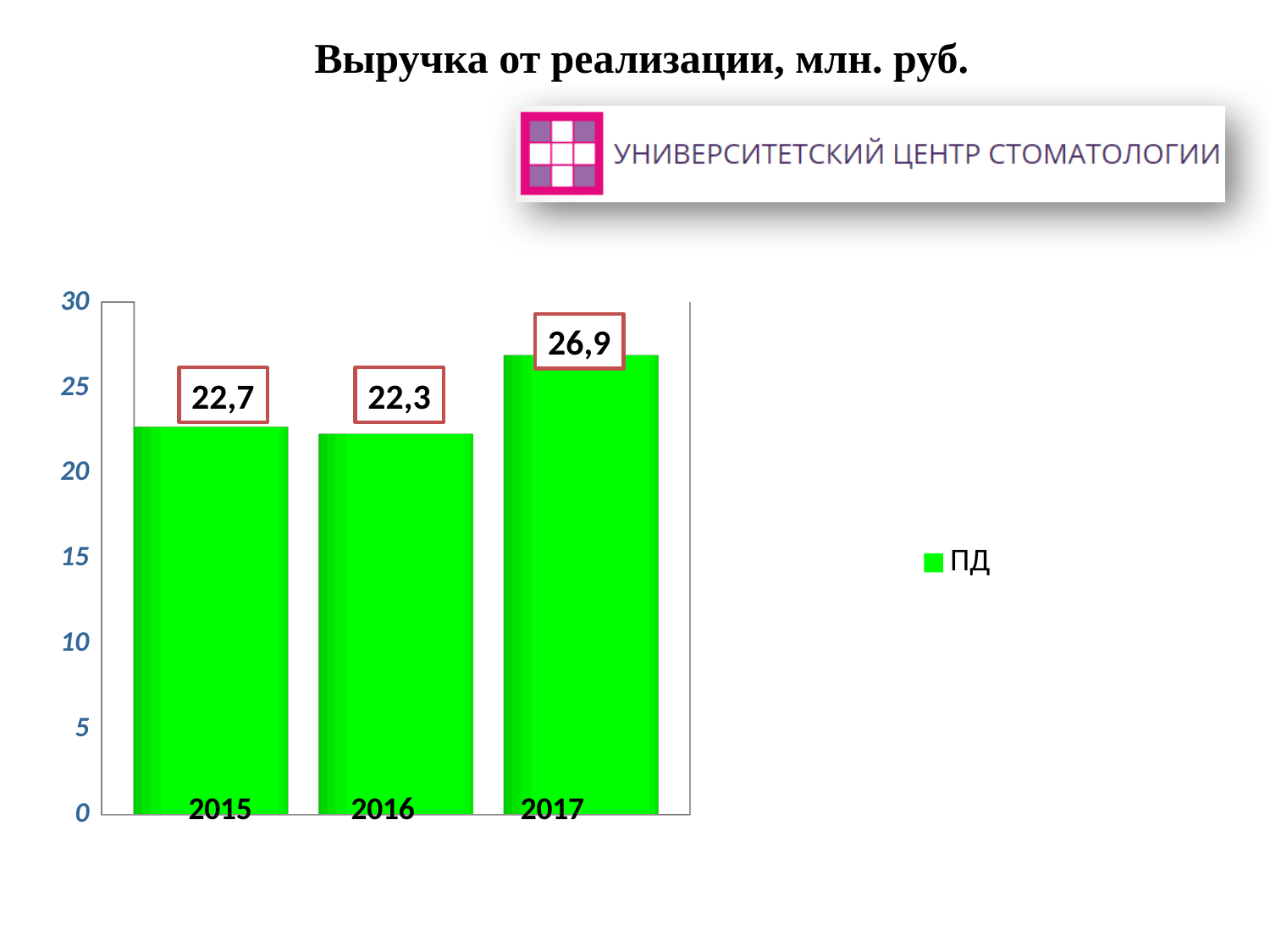
What is the difference between the values for 2017 and 2015? 4,2 What is the value for 2016? 22,3 What kind of chart is shown on the slide? bar chart What is the value for 2017? 26,9 Which year has the lowest value? 2016 Is the value for 2017 greater or less than 25? greater What is the value for 2015? 22,7 Which year has the highest value? 2017 How many years are shown on the chart? 3 What is the title of the chart? Выручка от реализации, млн. руб. Which is larger, the value for 2017 or the value for 2016? 2017 What is the difference between the values for 2015 and 2016? 0,4